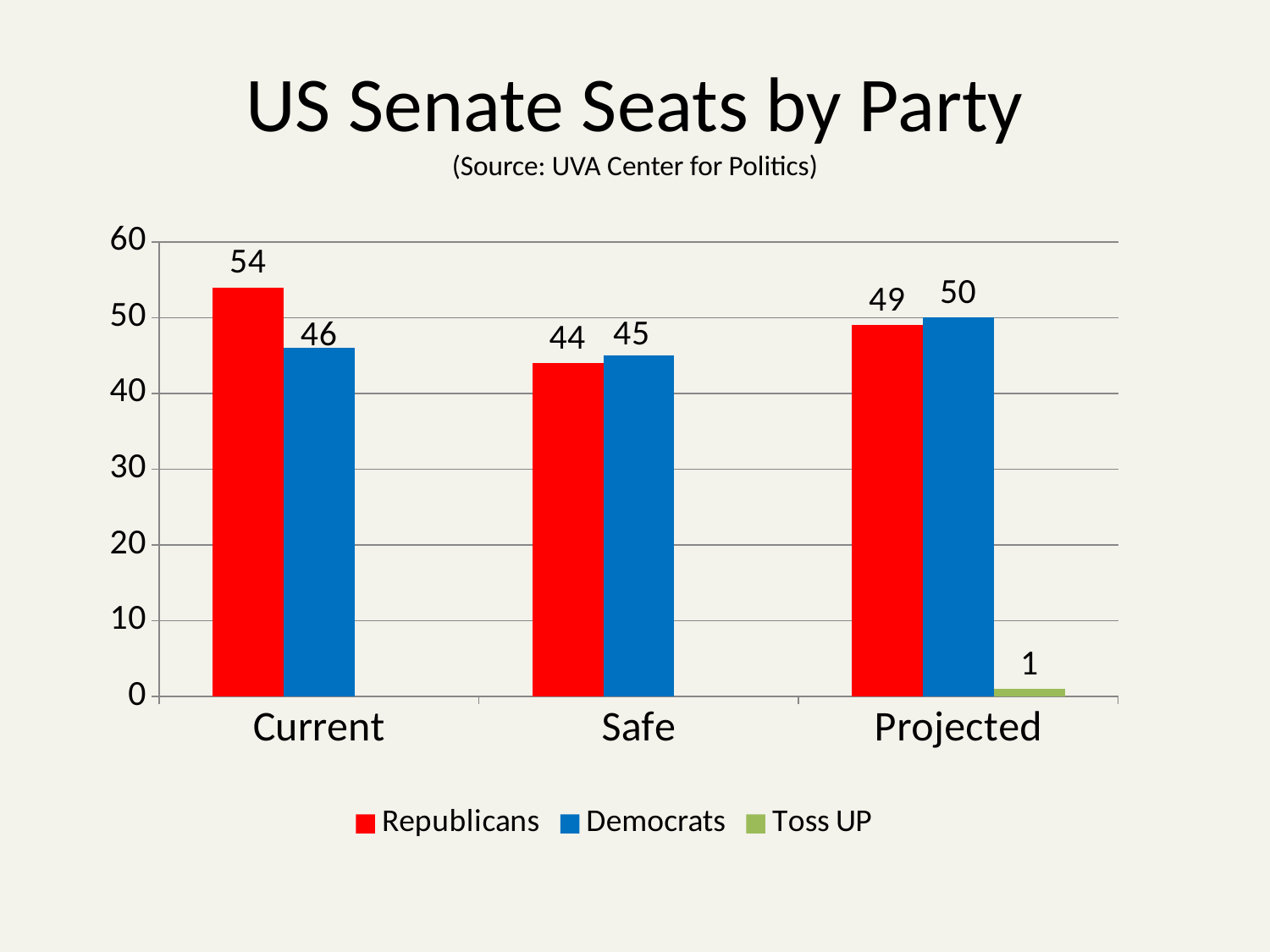
What kind of chart is shown on the slide? Bar chart How many series does the legend list? 3 In the Projected category, which series has the larger value, Republicans or Democrats? Democrats How many Senate seats do Republicans hold in the Current category? 54 What is the Toss UP value in the Projected category? 1 What is the Democrats value for the Safe category? 45 In which category is the Republicans value highest? Current What is the difference between the Republicans and Democrats values in the Current category? 8 What is the Republicans value for the Projected category? 49 What is the source cited under the chart title? UVA Center for Politics In which category is the Democrats value lowest? Safe How many categories are shown on the x axis? 3